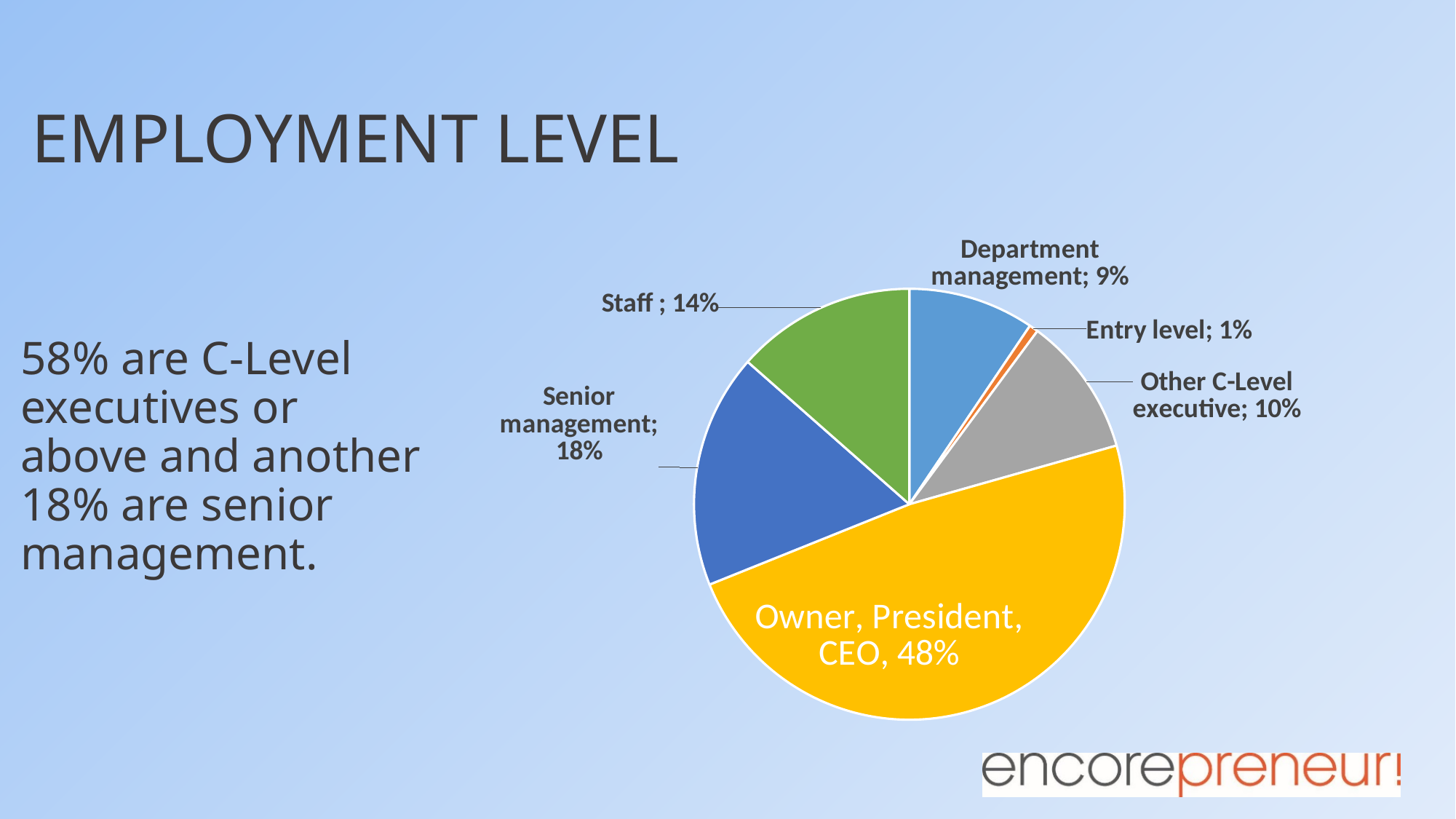
What is the value for Staff? 14% How many categories are shown in the pie chart? 6 What kind of chart is shown on the slide? Pie chart What is the value for Senior management? 18% What is the value for Department management? 9% Which category has the largest slice of the pie? Owner, President, CEO What share of the pie is Owner, President, CEO? 48% What is the difference between the Senior management and Staff values? 4% Which category has the smallest slice of the pie? Entry level What is the value for Other C-Level executive? 10% What is the title of the slide containing the chart? EMPLOYMENT LEVEL Which is larger, Other C-Level executive or Department management? Other C-Level executive